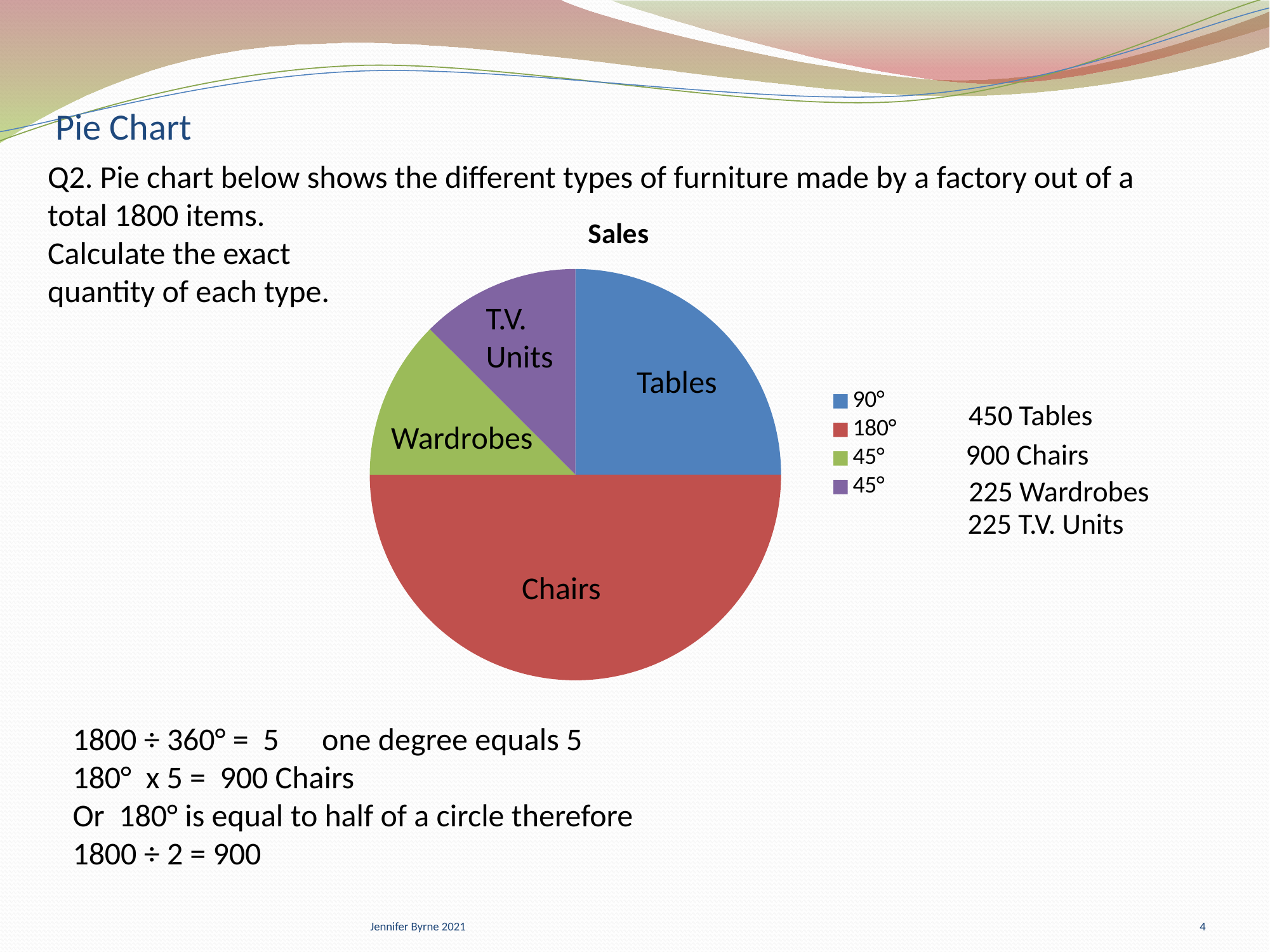
How many degrees does the Wardrobes slice represent according to the legend? 45° What is the title of the pie chart? Sales What colour is the Chairs slice in the pie chart? red What share of the pie does the Tables slice take up? 25% What share of the pie does the Chairs slice take up? 50% What is the difference in degrees between the Chairs slice and the Tables slice? 90° Which slice is larger, Tables or Wardrobes? Tables How many slices does the pie chart have? 4 Which slice of the pie chart is the largest? Chairs What kind of chart is shown on the slide? pie chart How many degrees does the Tables slice represent according to the legend? 90° How many degrees does the Chairs slice represent according to the legend? 180°